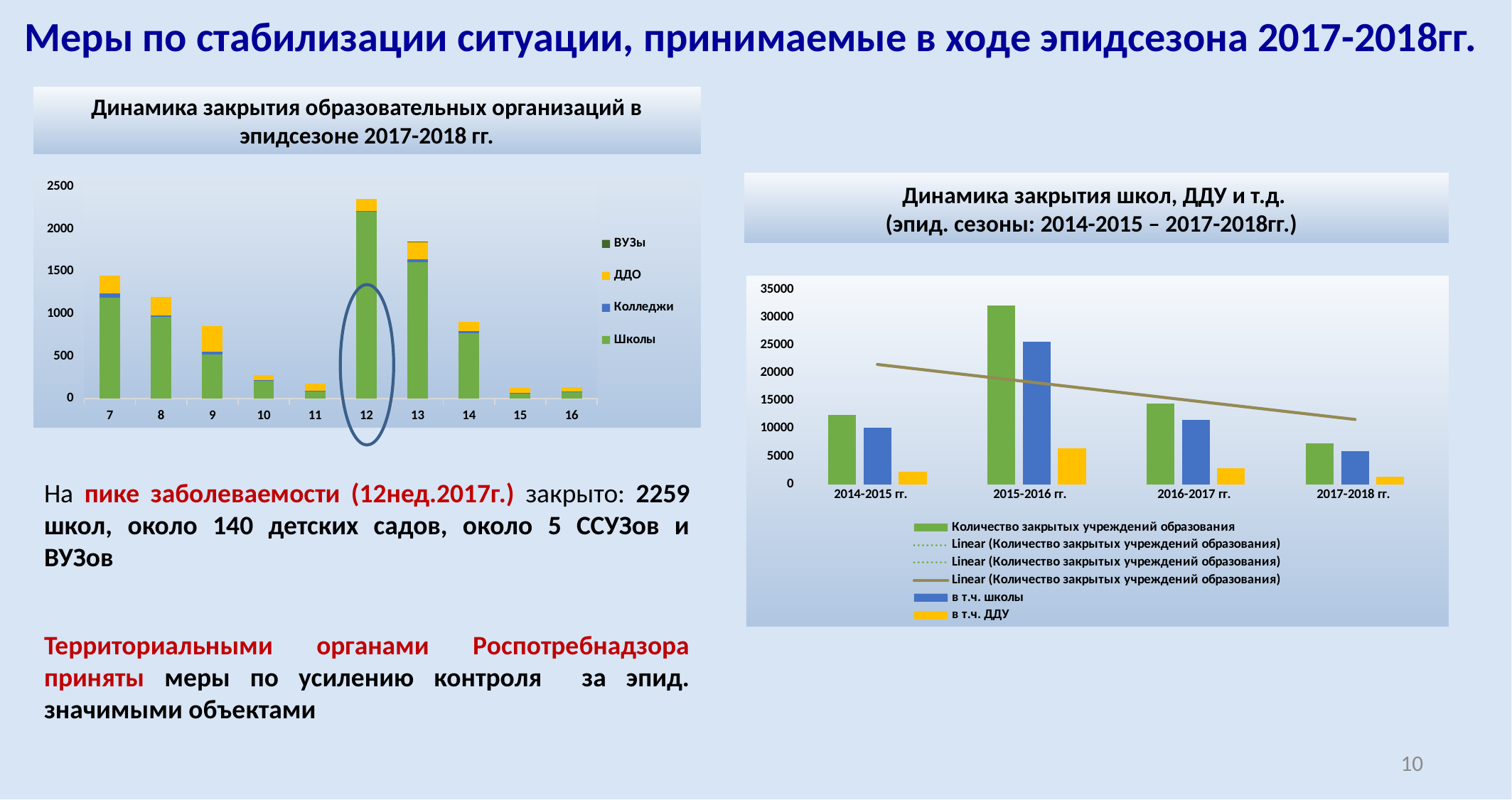
In the right chart 'Динамика закрытия школ, ДДУ и т.д.', which season has the lowest value for 'Количество закрытых учреждений образования'? 2017-2018 гг. In the right chart 'Динамика закрытия школ, ДДУ и т.д.', which season has the highest value for 'Количество закрытых учреждений образования'? 2015-2016 гг. In the left chart 'Динамика закрытия образовательных организаций', is the total for week 10 greater or less than 500? less What kind of chart is the left chart titled 'Динамика закрытия образовательных организаций в эпидсезоне 2017-2018 гг.'? stacked bar chart In the left chart 'Динамика закрытия образовательных организаций', is the total for week 12 greater or less than 2000? greater In the left chart 'Динамика закрытия образовательных организаций', which week has the highest total bar? 12 In the left chart 'Динамика закрытия образовательных организаций', which is larger: the total bar for week 8 or for week 9? week 8 In the left chart 'Динамика закрытия образовательных организаций', how many series does the legend list? 4 In the right chart 'Динамика закрытия школ, ДДУ и т.д.', which is larger: the 'в т.ч. ДДУ' value for 2015-2016 гг. or for 2014-2015 гг.? 2015-2016 гг. In the left chart 'Динамика закрытия образовательных организаций', how many weeks are shown on the x axis? 10 In the right chart 'Динамика закрытия школ, ДДУ и т.д.', how many epidemic seasons are shown on the x axis? 4 In the right chart 'Динамика закрытия школ, ДДУ и т.д.', is the value for 'Количество закрытых учреждений образования' in 2015-2016 гг. greater or less than 30000? greater